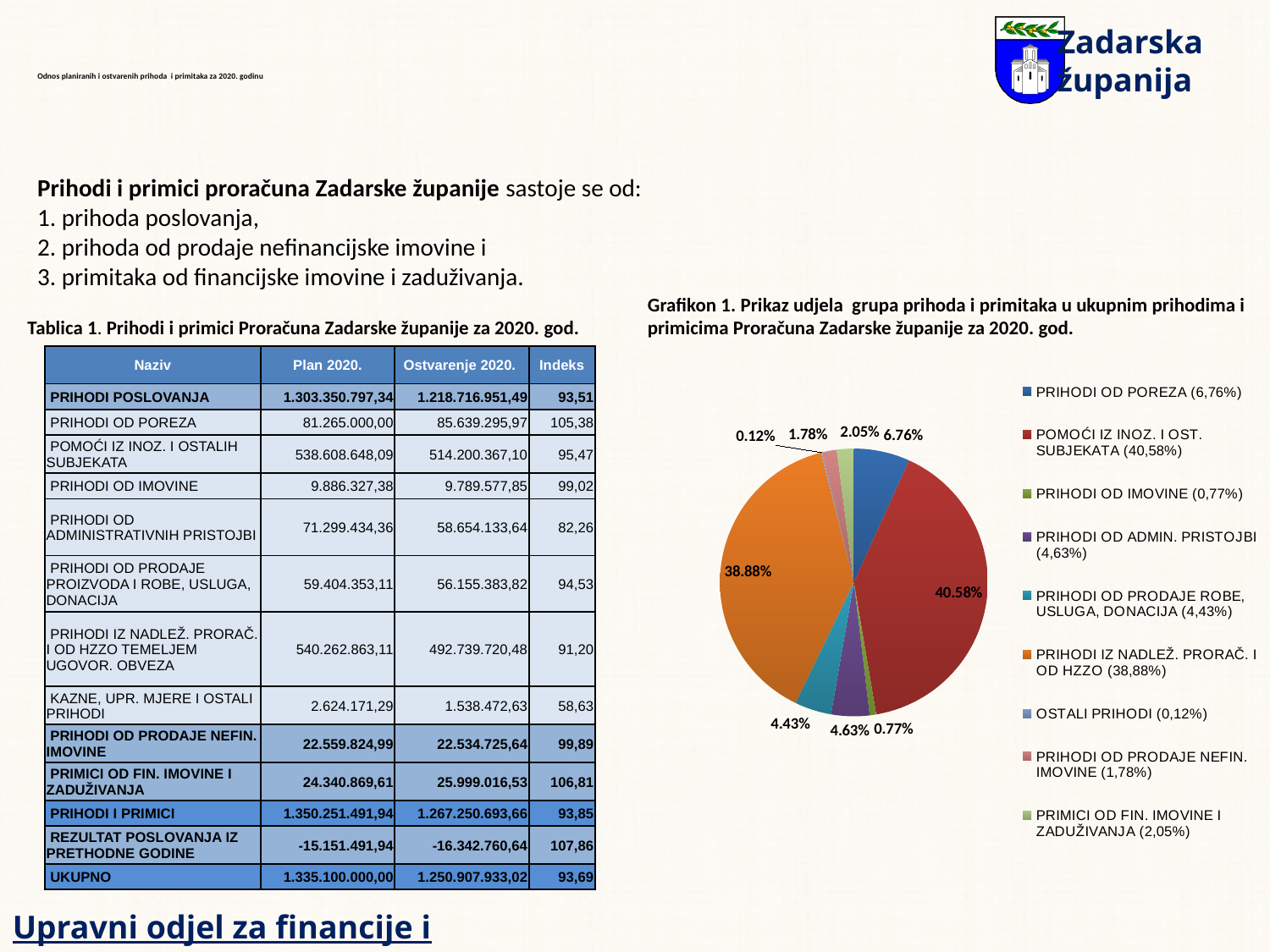
What kind of chart is Grafikon 1 on the slide? pie chart Which category has the largest slice in the pie chart? POMOĆI IZ INOZ. I OST. SUBJEKATA In the pie chart, what share is shown for POMOĆI IZ INOZ. I OST. SUBJEKATA? 40.58% In the pie chart, what share is shown for PRIMICI OD FIN. IMOVINE I ZADUŽIVANJA? 2.05% How many slices does the pie chart have? 9 In the pie chart, what share is shown for PRIHODI IZ NADLEŽ. PRORAČ. I OD HZZO? 38.88% What colour is the PRIHODI IZ NADLEŽ. PRORAČ. I OD HZZO slice in the pie chart? orange Which slice is larger in the pie chart: PRIHODI OD ADMIN. PRISTOJBI or PRIHODI OD PRODAJE NEFIN. IMOVINE? PRIHODI OD ADMIN. PRISTOJBI Which category has the smallest slice in the pie chart? OSTALI PRIHODI What is the difference in percentage points between the POMOĆI IZ INOZ. I OST. SUBJEKATA slice and the PRIHODI IZ NADLEŽ. PRORAČ. I OD HZZO slice? 1.70